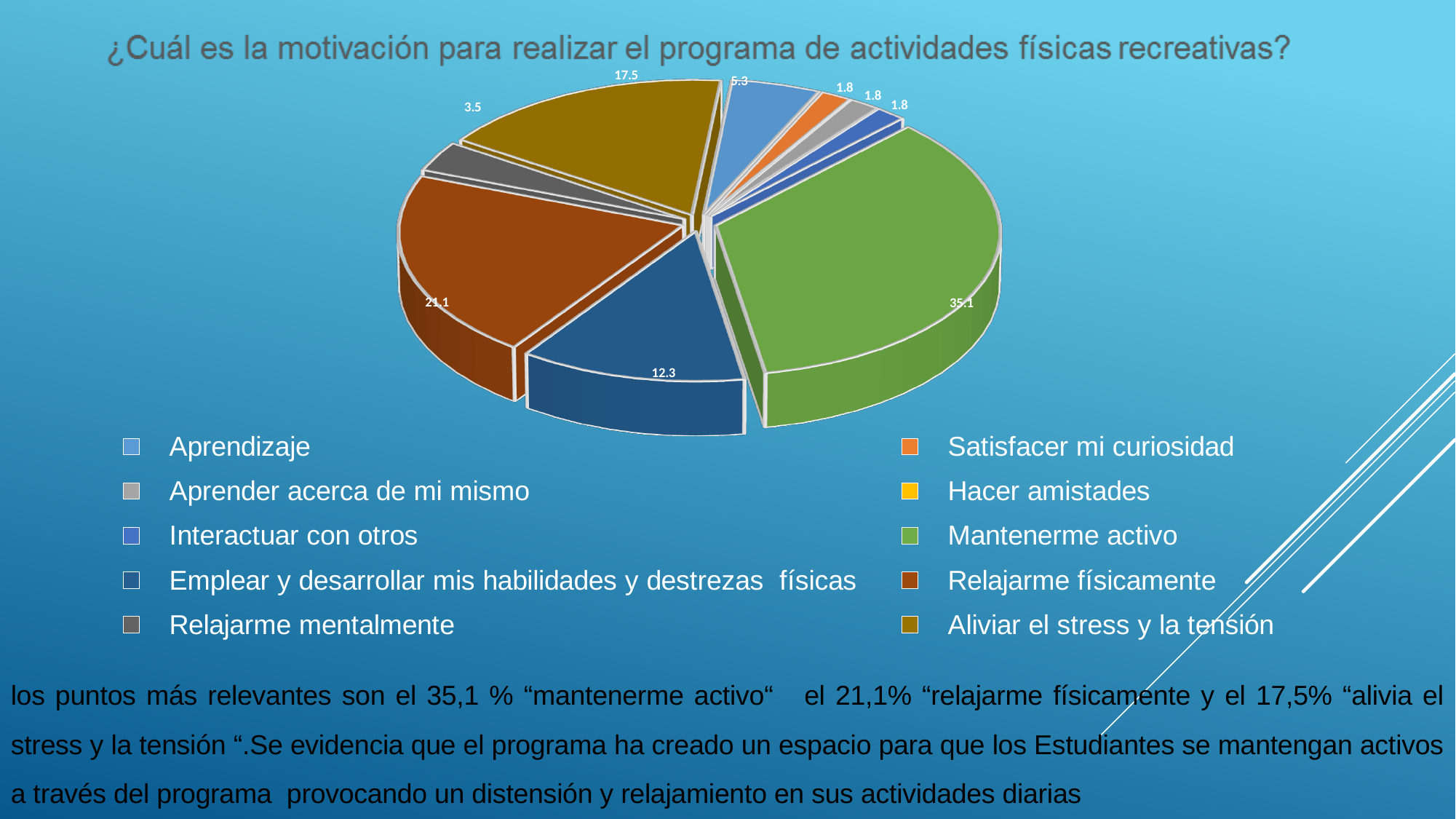
What is the value shown for the "Aprendizaje" slice? 5.3 How many categories does the legend list? 10 What is the title of the chart? ¿Cuál es la motivación para realizar el programa de actividades físicas recreativas? What is the value shown for the "Emplear y desarrollar mis habilidades y destrezas físicas" slice? 12.3 What is the value shown for the "Mantenerme activo" slice? 35.1 Which category has the largest slice of the pie? Mantenerme activo What is the value shown for the "Relajarme físicamente" slice? 21.1 What is the difference between the values for "Mantenerme activo" and "Relajarme físicamente"? 14.0 What is the value shown for the "Relajarme mentalmente" slice? 3.5 Which is larger, the value for "Aliviar el stress y la tensión" or the value for "Emplear y desarrollar mis habilidades y destrezas físicas"? Aliviar el stress y la tensión What kind of chart is shown on the slide? Pie chart What is the value shown for the "Aliviar el stress y la tensión" slice? 17.5